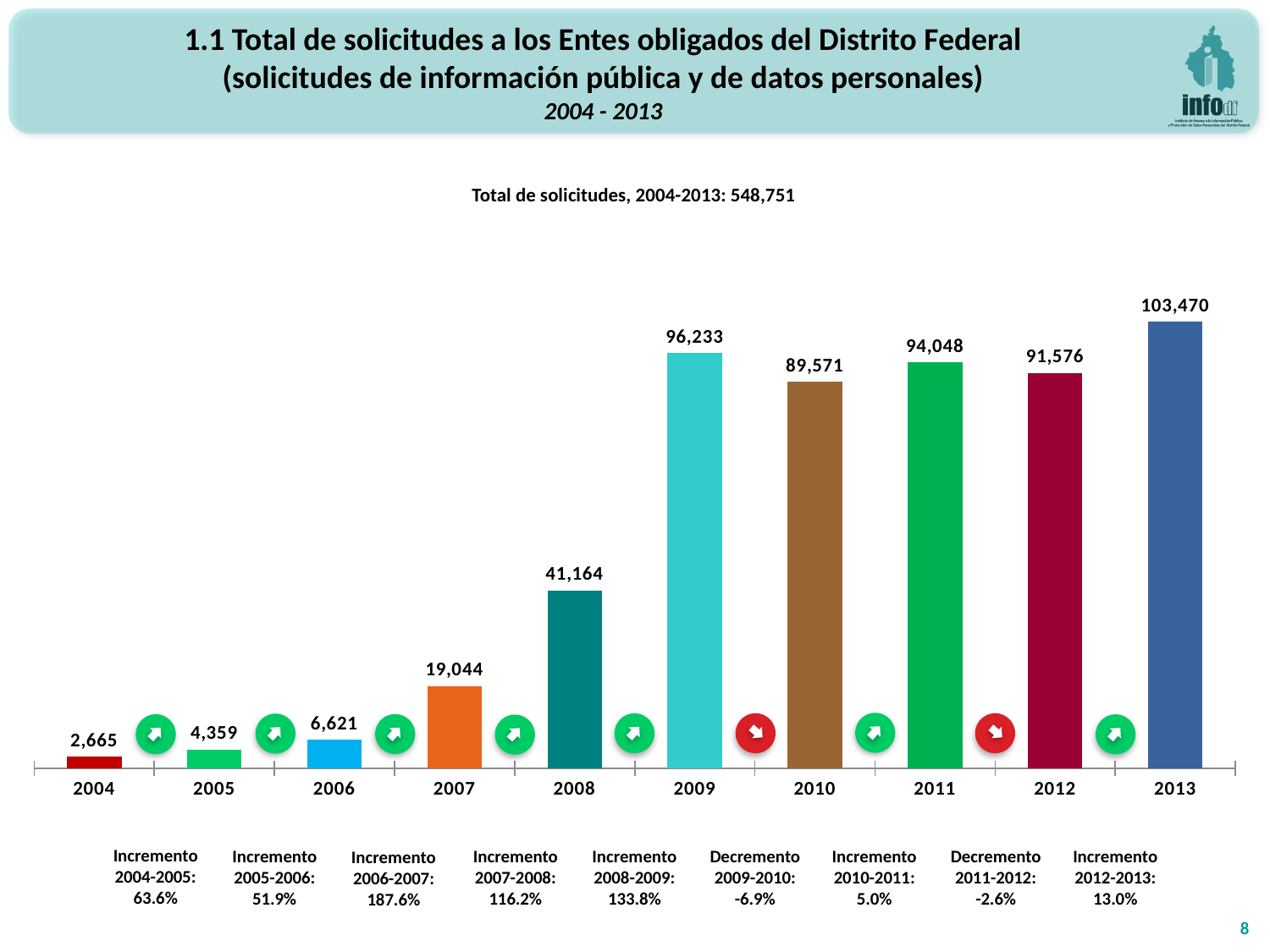
Which is larger, the value for 2009 or the value for 2010? 2009 What kind of chart is shown on the slide? bar chart What is the difference between the values for 2009 and 2010? 6,662 What is the value for 2013? 103,470 What is the value for 2008? 41,164 How many years are shown on the x axis? 10 Which is larger, the value for 2011 or the value for 2012? 2011 Which year has the lowest value? 2004 What is the difference between the values for 2013 and 2012? 11,894 Which year has the highest value? 2013 What total of solicitudes for 2004-2013 is stated above the chart? 548,751 What is the value for 2004? 2,665